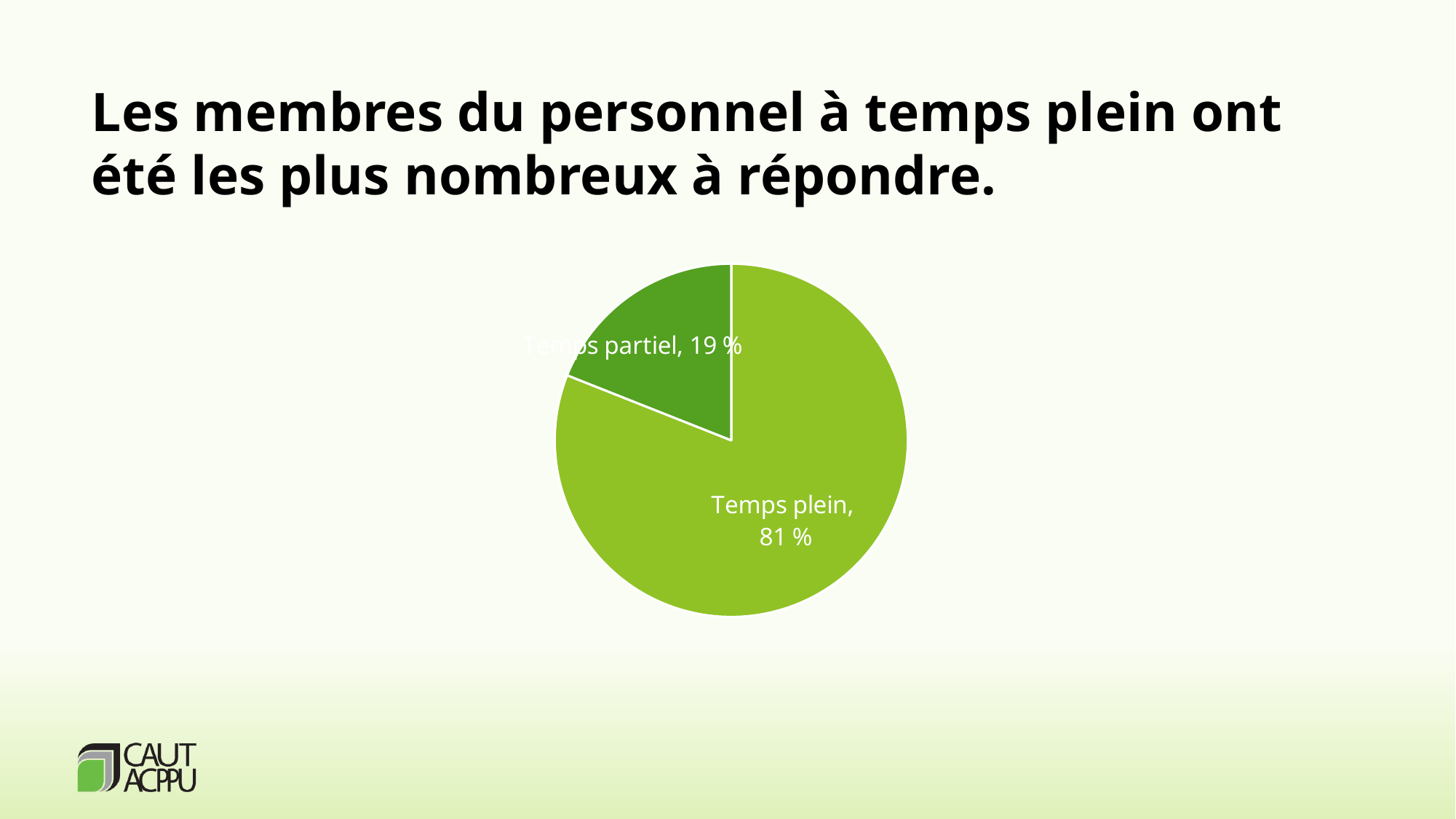
What share of the pie is Temps plein? 81 % What is the combined share of the Temps plein and Temps partiel slices? 100 % How many slices does the pie chart have? 2 What is the difference in percentage points between the Temps plein and Temps partiel slices? 62 What share of the pie is Temps partiel? 19 % Which is larger, the Temps plein slice or the Temps partiel slice? Temps plein What is the title text on the slide above the chart? Les membres du personnel à temps plein ont été les plus nombreux à répondre. Which slice of the pie is the largest? Temps plein What kind of chart is shown on the slide? pie chart Which slice is drawn in the darker green colour? Temps partiel Which slice of the pie is the smallest? Temps partiel